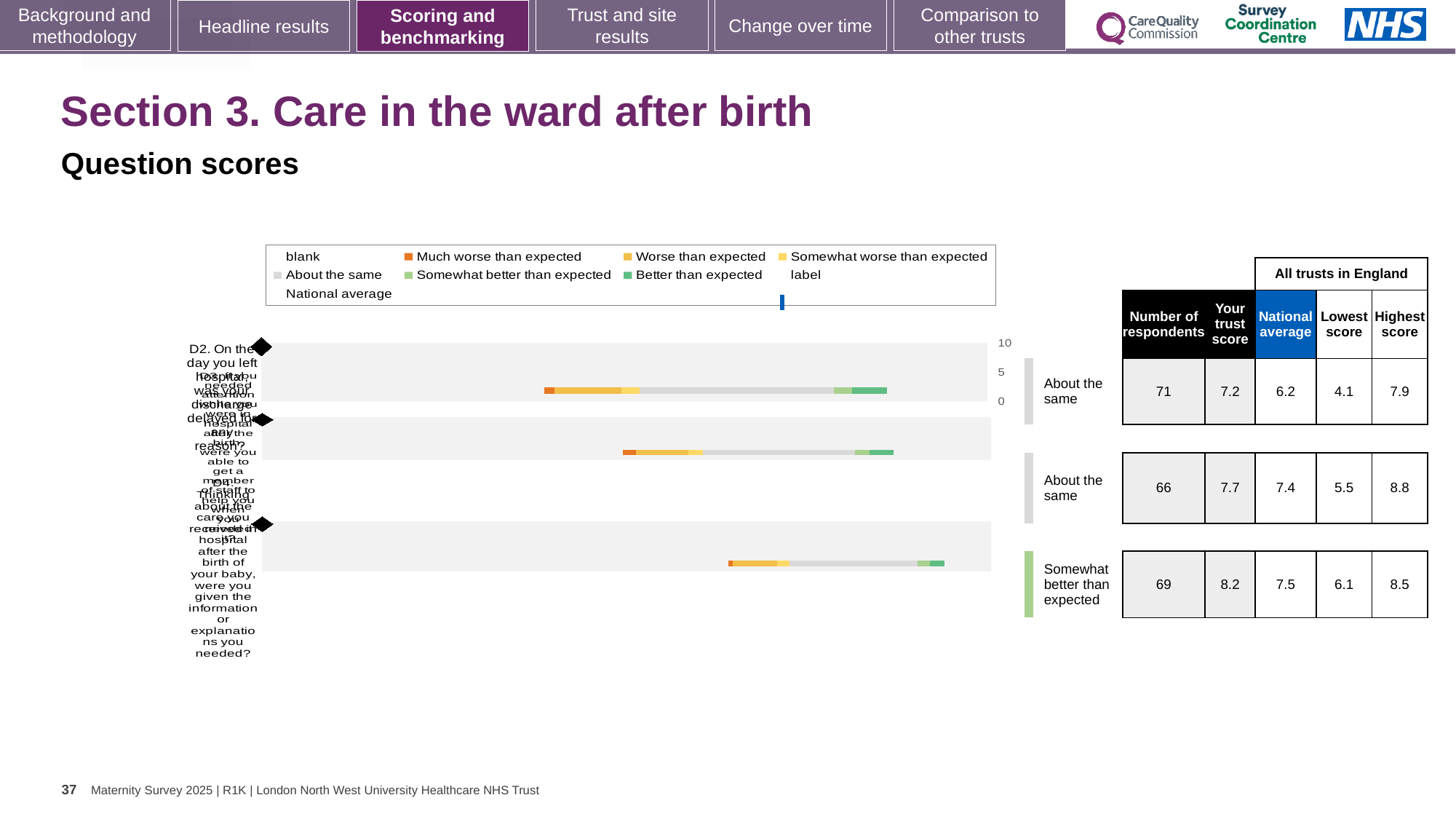
What label is shown beside the top bar of the chart? About the same What label is shown beside the bottom bar of the chart? Somewhat better than expected Which colour does the legend use for 'Much worse than expected'? orange How many bars are plotted in the chart? 3 What is the highest value shown on the chart's numeric axis? 10 What kind of chart is shown on the slide? bar chart